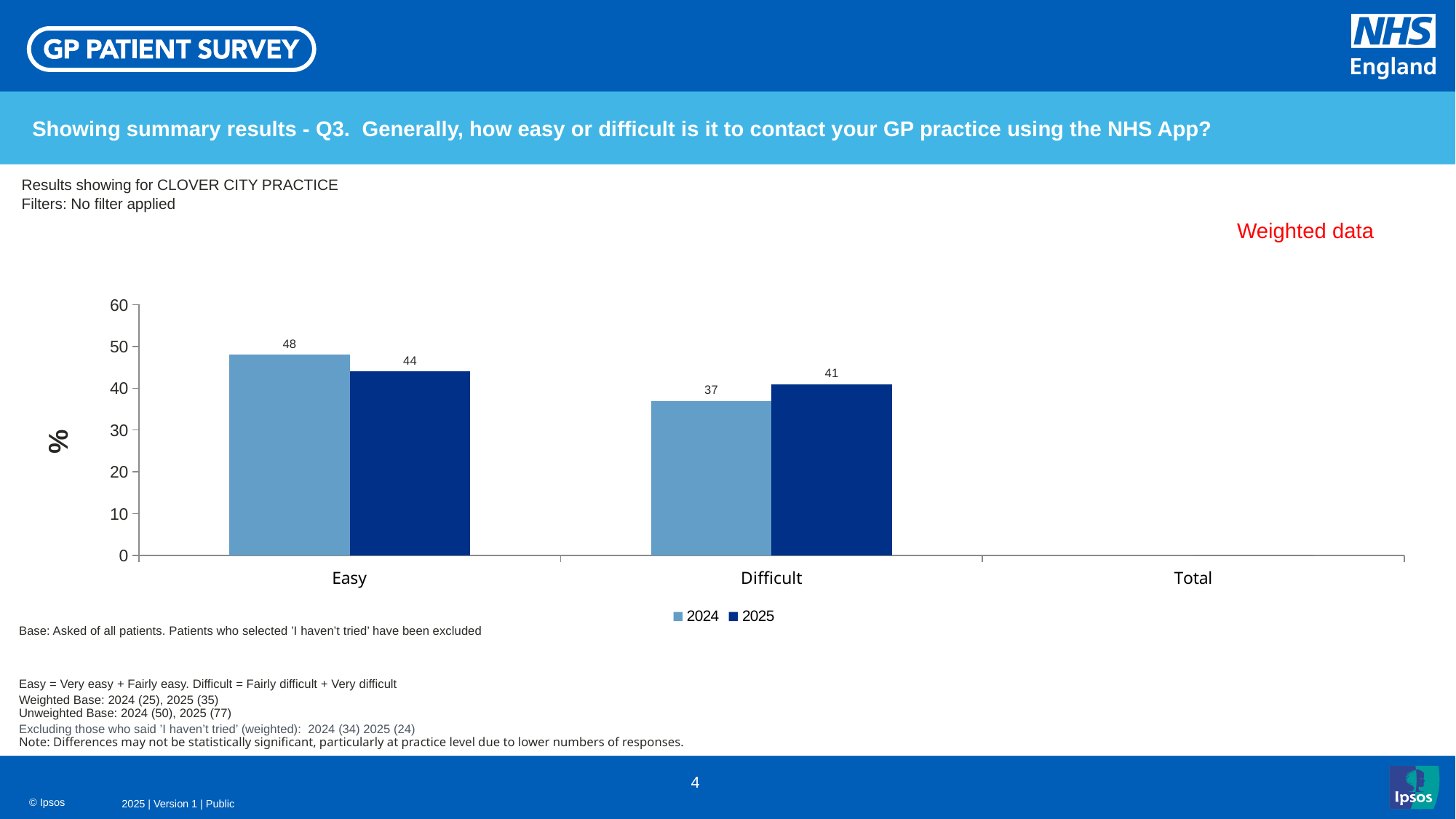
What kind of chart is shown on the slide? Bar chart Which category has the lowest value in the 2025 series? Difficult What is the difference between the 2024 and 2025 values for Easy? 4 Which is larger for Difficult: the 2024 value or the 2025 value? 2025 What is the value for Easy in 2025? 44 What label is shown on the vertical axis? % How many series does the legend list? 2 What is the value for Easy in 2024? 48 What is the value for Difficult in 2025? 41 What is the value for Difficult in 2024? 37 Which category has the highest value in the 2024 series? Easy Is the value for Easy in 2024 greater or less than 40? greater